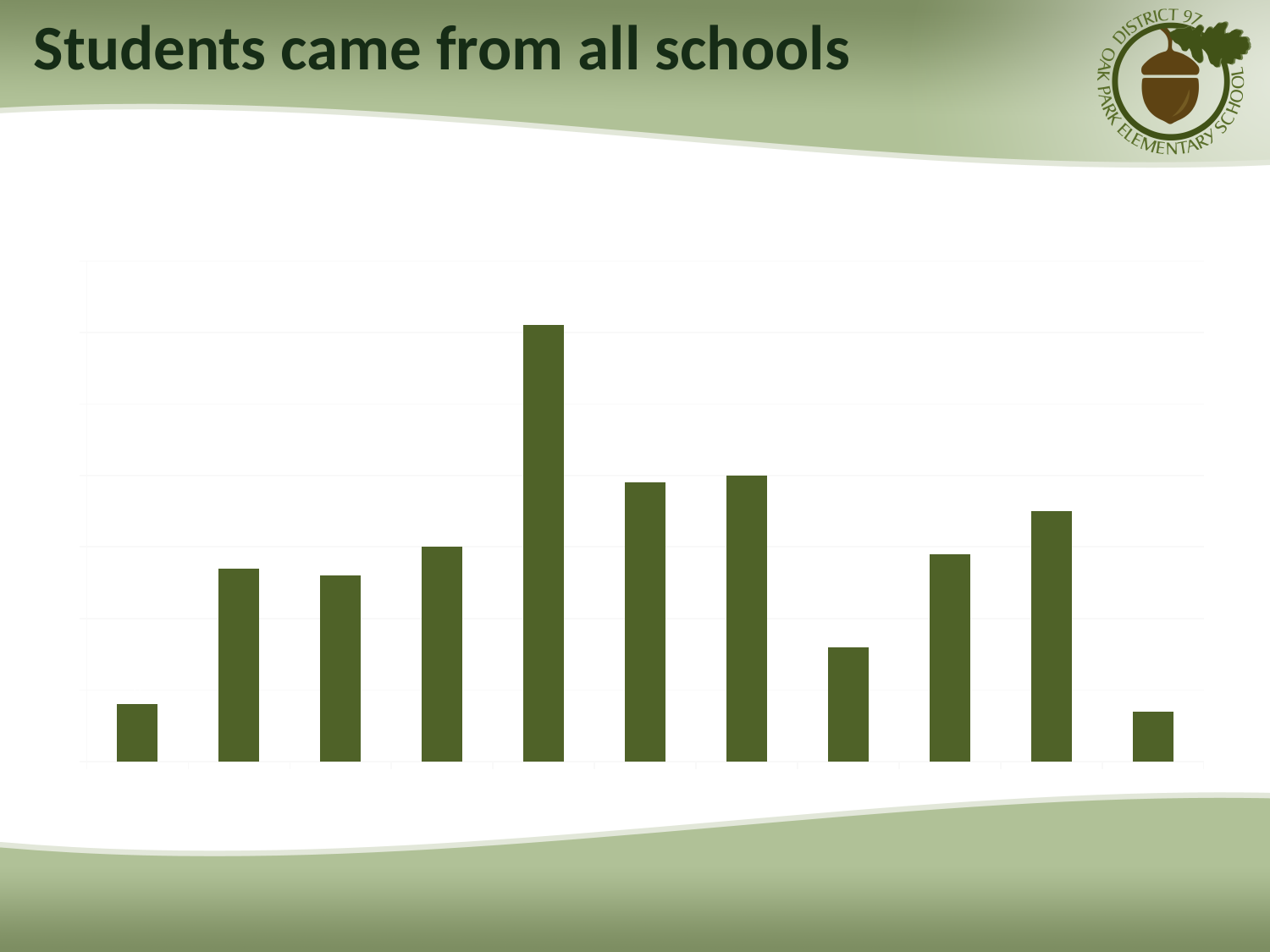
What kind of chart is shown on the slide? bar chart What is the title of the slide containing the chart? Students came from all schools Counting from the left, which bar in the chart is the tallest? the fifth bar What colour are the bars in the chart? green Which is taller in the chart: the fourth bar from the left or the fifth bar from the left? the fifth bar How many bars does the chart contain? 11 Which is taller in the chart: the seventh bar from the left or the tenth bar from the left? the seventh bar Which is taller in the chart: the second bar from the left or the eighth bar from the left? the second bar